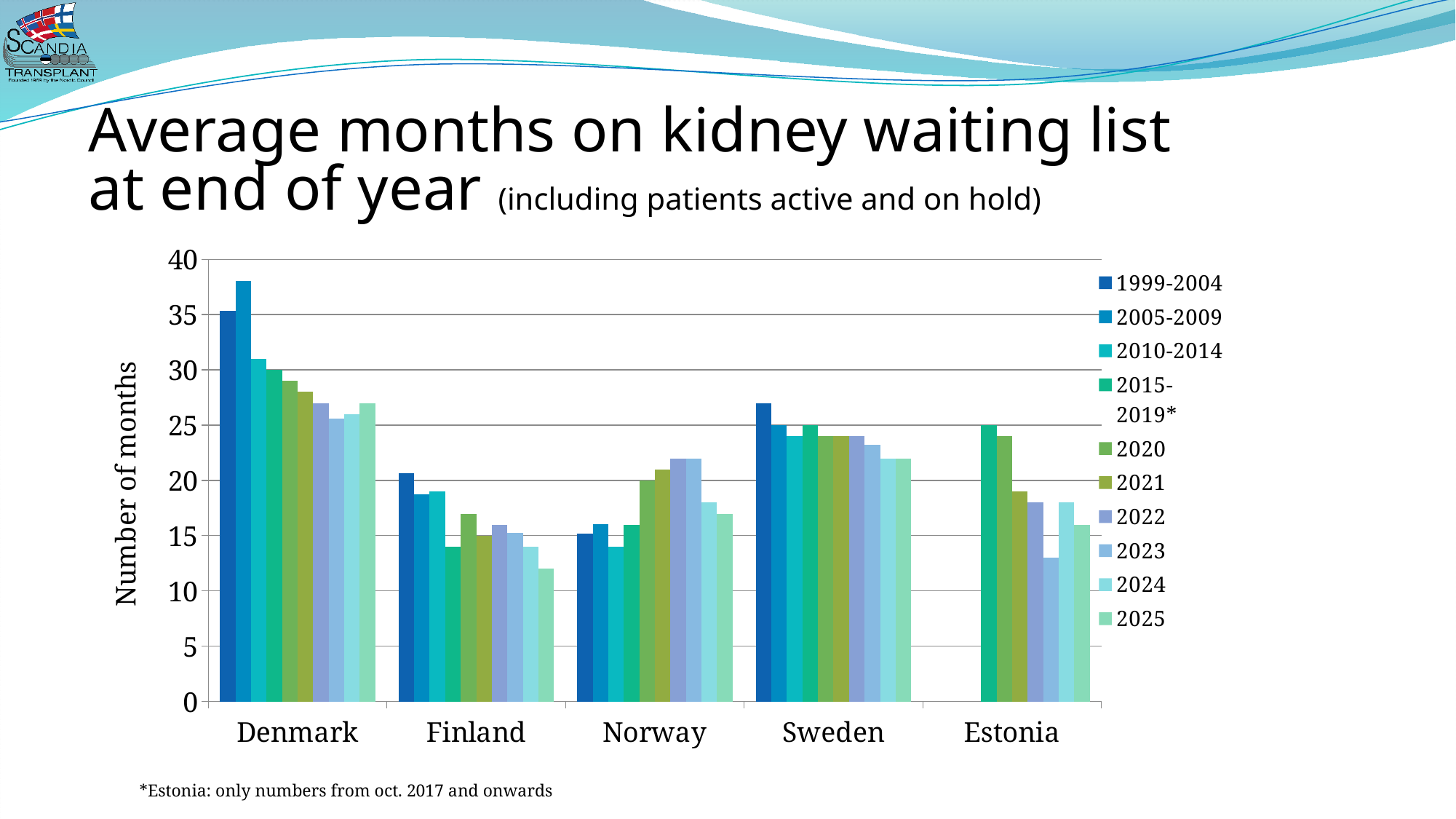
What is the label on the y axis? Number of months Is the value for Estonia in 2023 greater or less than 15? less How many series does the legend list? 10 Which country has the highest bar for 2005-2009? Denmark From 2005-2009 to 2023, do Denmark's values rise or fall? fall Is the value for Norway in 2022 greater or less than 20? greater Which is larger for 1999-2004: Denmark or Sweden? Denmark What kind of chart is shown on the slide? bar chart Is the value for Denmark in 2005-2009 greater or less than 35? greater Which country has the lowest bar for 2025? Finland How many countries are shown on the x axis? 5